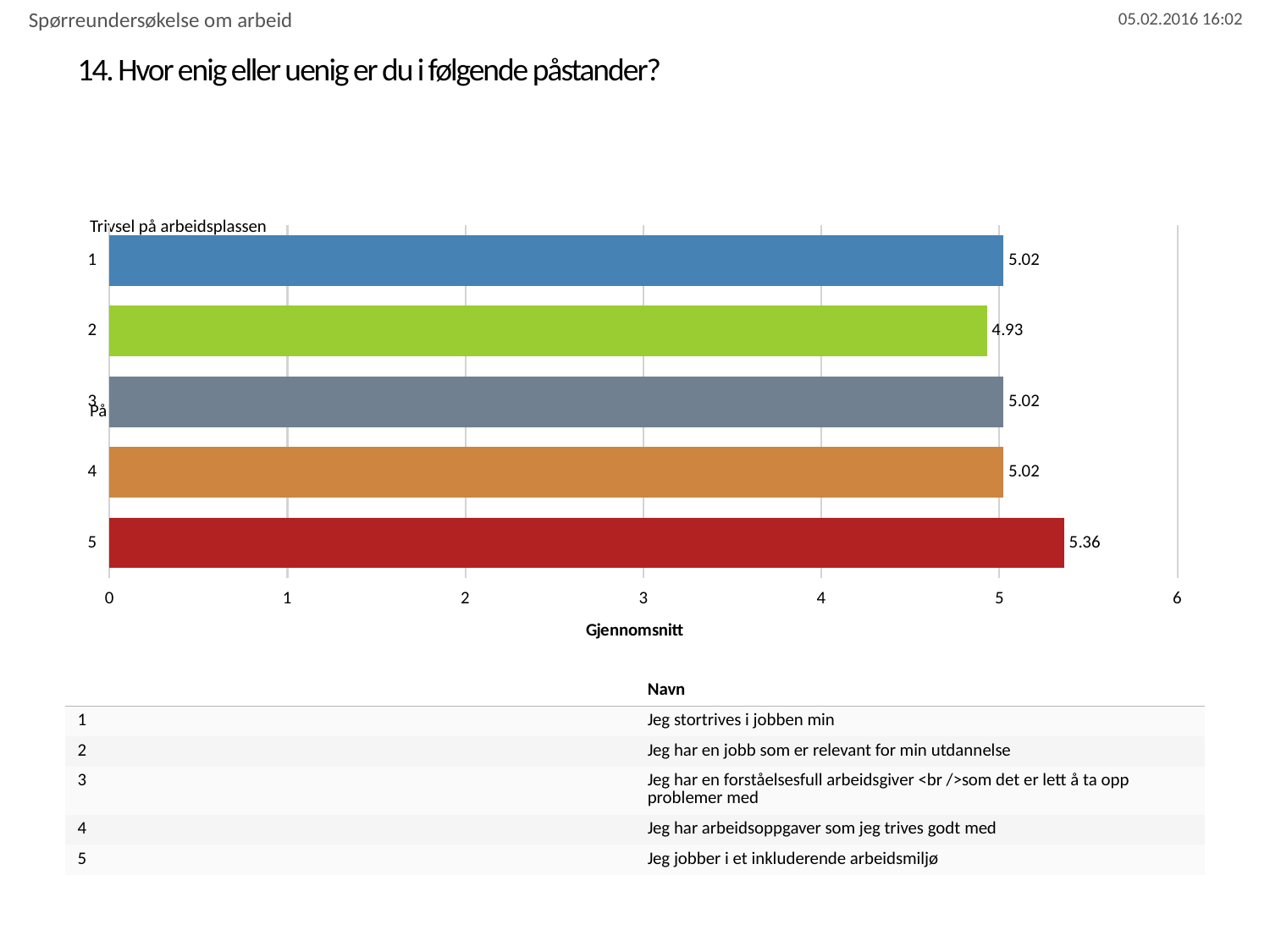
What is the difference between the values for category 5 and category 1? 0.34 What is the value for category 2 in the chart? 4.93 What is the value for category 1 in the chart? 5.02 What is the difference between the values for category 5 and category 2? 0.43 What is the value for category 5 in the chart? 5.36 How many bars are shown in the chart? 5 Which category has the lowest value in the chart? 2 Which is larger, the value for category 5 or the value for category 4? 5 Which category has the highest value in the chart? 5 Is the value for category 2 greater or less than 5? less What is the label on the horizontal axis of the chart? Gjennomsnitt What kind of chart is shown on the slide? bar chart